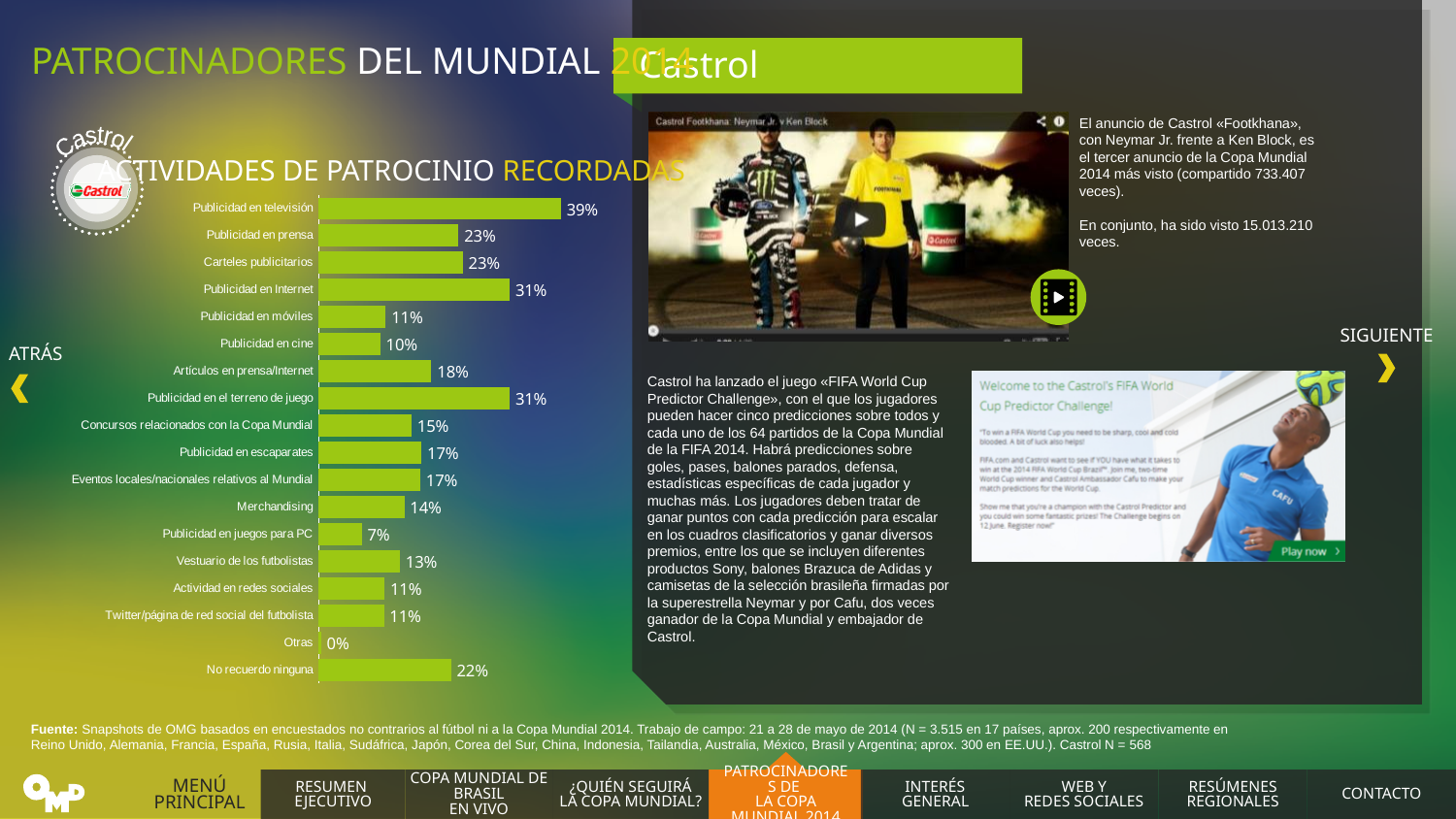
What is the value for Publicidad en juegos para PC? 7% What is the value for Publicidad en televisión? 39% Which category has the lowest value? Otras Which category has the highest value? Publicidad en televisión What is the difference between Publicidad en televisión and Publicidad en Internet? 8% What is the title of the chart? ACTIVIDADES DE PATROCINIO RECORDADAS What is the value for No recuerdo ninguna? 22% Which is larger, Vestuario de los futbolistas or Publicidad en escaparates? Publicidad en escaparates What is the difference between Artículos en prensa/Internet and Publicidad en cine? 8% What kind of chart is shown? Bar chart What is the value for Merchandising? 14% How many categories does the chart show? 18